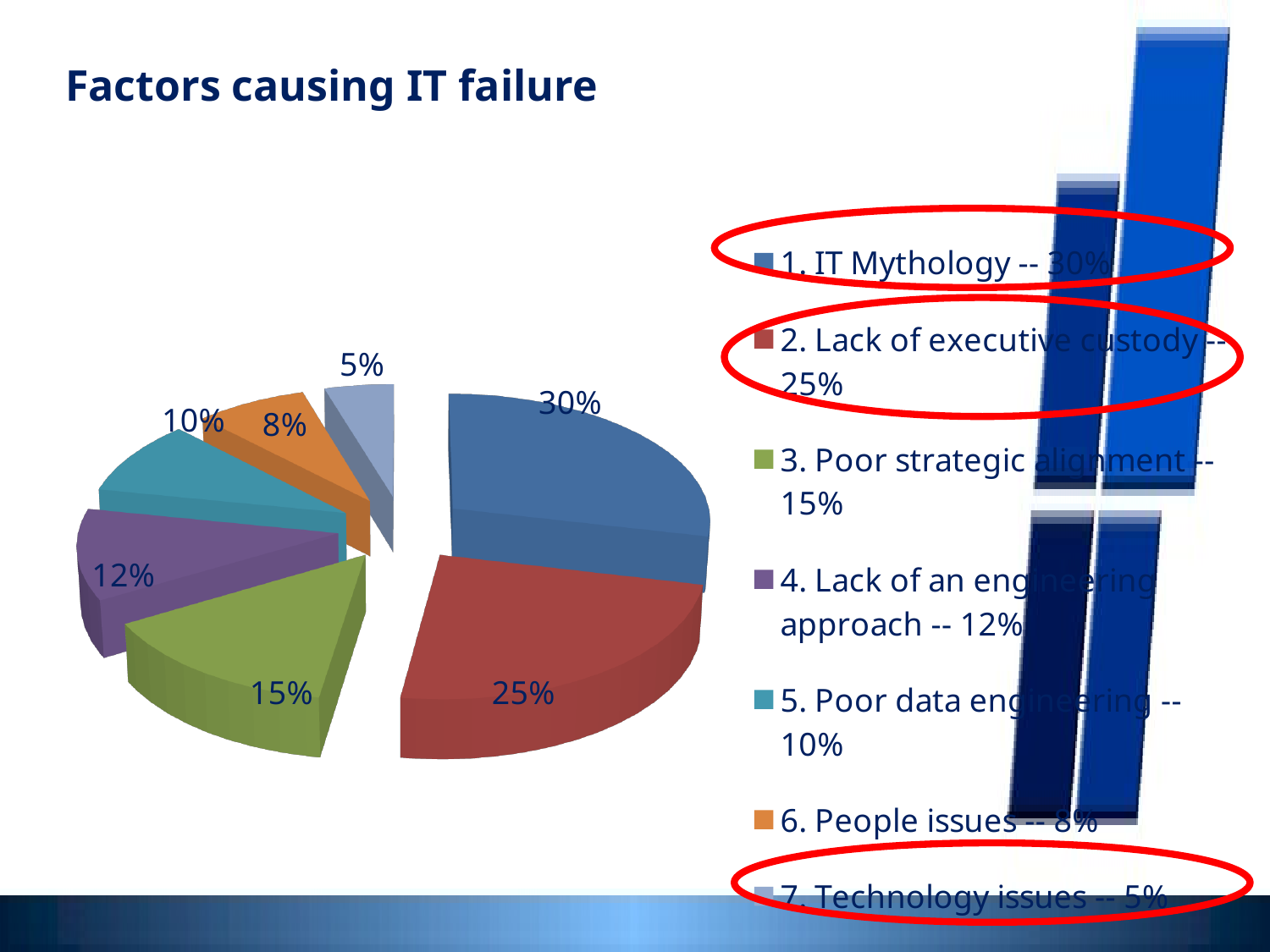
What kind of chart is shown on the slide? Pie chart What is the value for Lack of executive custody? 25% What is the combined share of Lack of an engineering approach and Poor data engineering? 22% What is the title of the slide containing the pie chart? Factors causing IT failure Which factor has the smallest slice of the pie? 7. Technology issues What share of the pie does IT Mythology account for? 30% How many slices does the pie chart have? 7 What is the difference between the values for IT Mythology and Lack of executive custody? 5% Which is larger, the value for Poor data engineering or the value for People issues? Poor data engineering What is the value for Poor strategic alignment? 15% What is the value for Technology issues? 5% Which factor has the largest slice of the pie? 1. IT Mythology